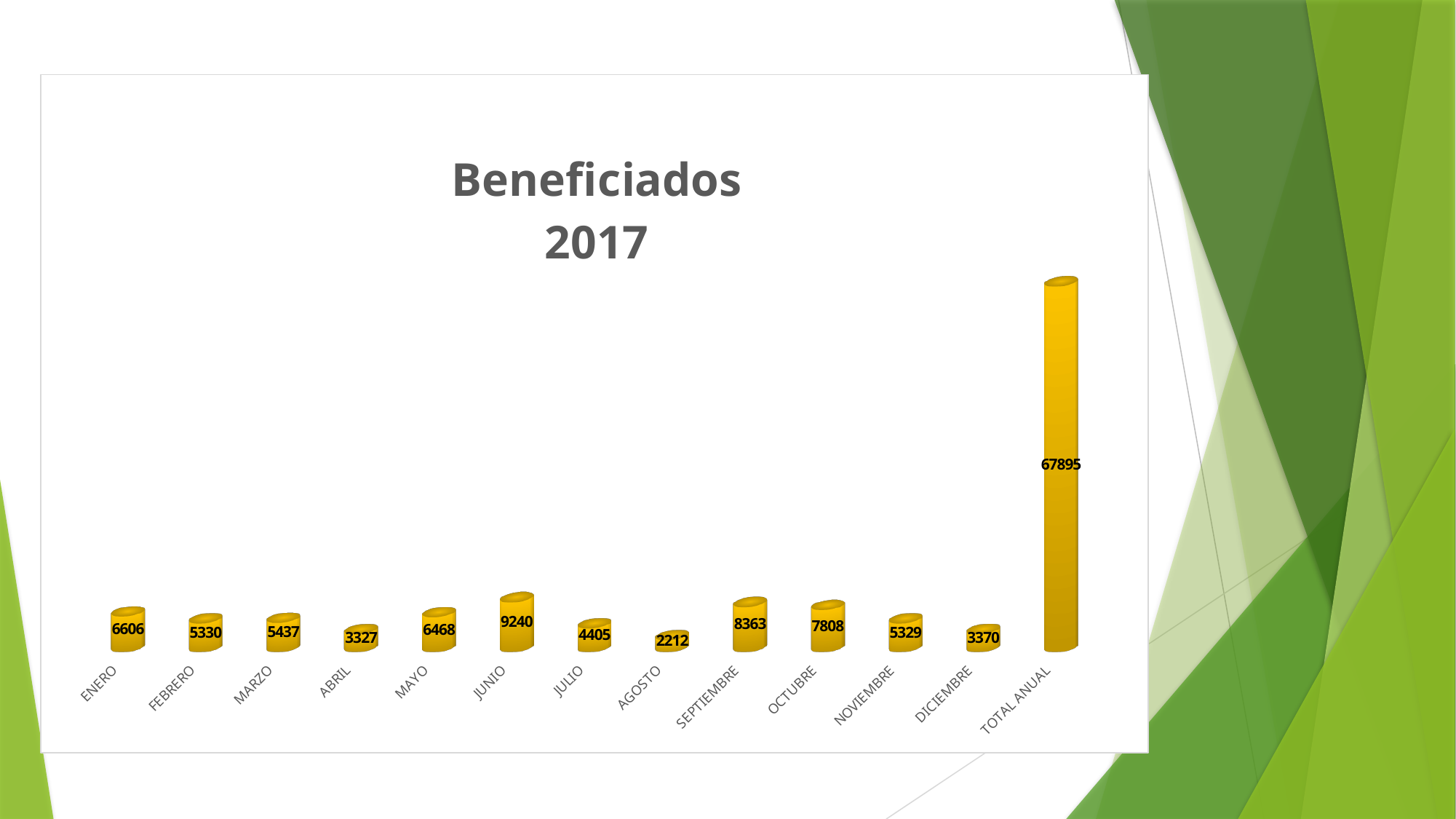
What is the difference between the values for JUNIO and AGOSTO? 7028 Which category has the lowest value? AGOSTO What kind of chart is this? bar chart What is the difference between the values for OCTUBRE and NOVIEMBRE? 2479 Which is larger, the value for ENERO or the value for MAYO? ENERO What is the value for SEPTIEMBRE? 8363 How many categories are shown on the x axis? 13 What is the value for AGOSTO? 2212 What is the value for TOTAL ANUAL? 67895 What is the value for JUNIO? 9240 Which month has the highest value (excluding TOTAL ANUAL)? JUNIO What is the title of the chart? Beneficiados 2017